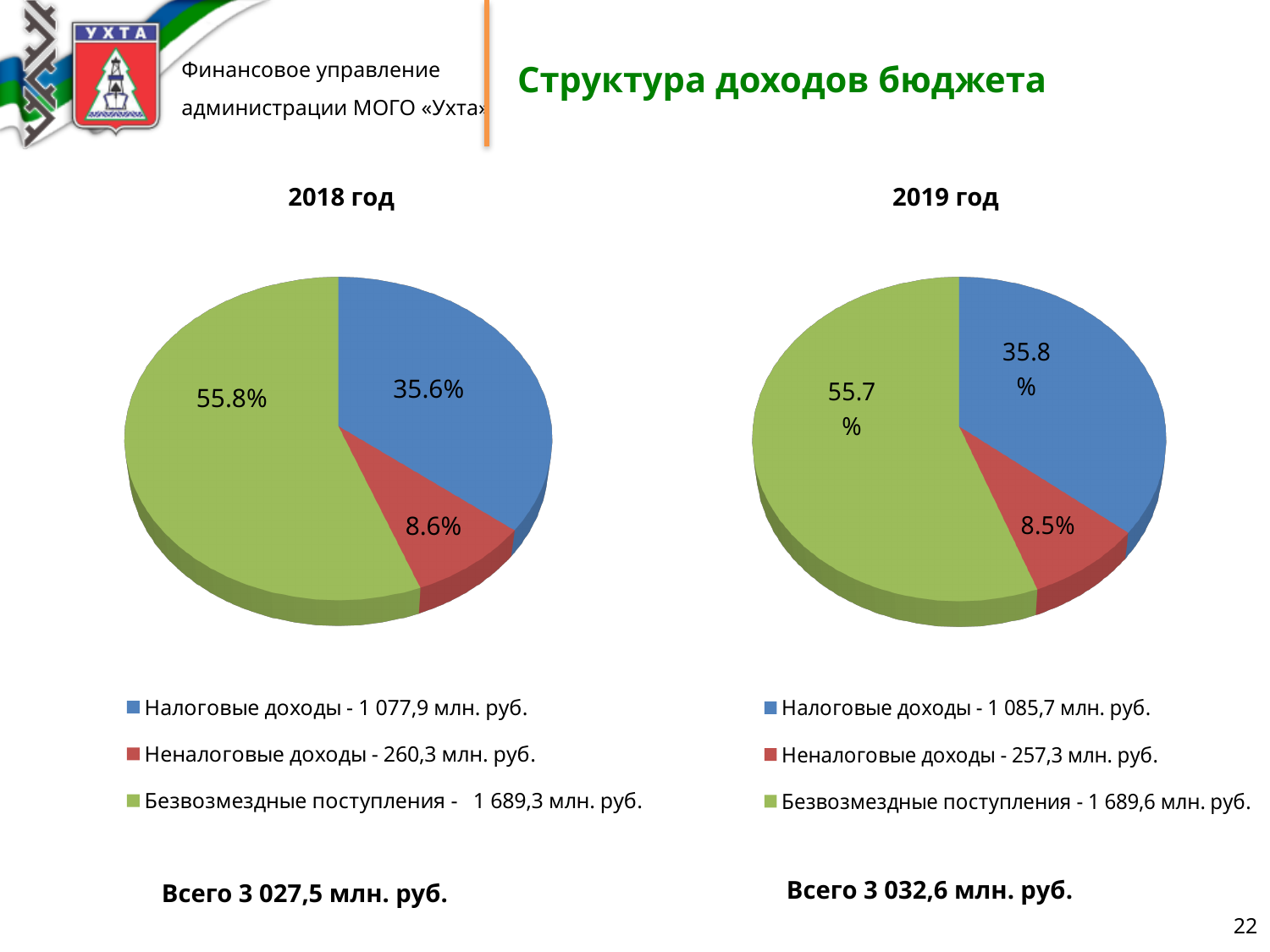
How many slices does the 2018 год pie chart have? 3 In the 2019 год chart, which is larger: the Налоговые доходы slice or the Неналоговые доходы slice? Налоговые доходы In the 2019 год chart, what share of the pie is labelled for Неналоговые доходы? 8.5% In the 2018 год chart, what is the difference in percentage points between the Безвозмездные поступления slice and the Налоговые доходы slice? 20.2 In the 2019 год chart, which category has the largest slice? Безвозмездные поступления In the 2018 год chart, what share of the pie is labelled for Неналоговые доходы? 8.6% In the 2019 год chart, what share of the pie is labelled for Безвозмездные поступления? 55.7% In the 2019 год chart, what amount does the legend give for Налоговые доходы? 1 085,7 млн. руб. In the 2018 год chart, which category has the smallest slice? Неналоговые доходы What colour is the Безвозмездные поступления slice in the 2018 год chart? green What kind of chart is used for the 2018 год chart? pie chart